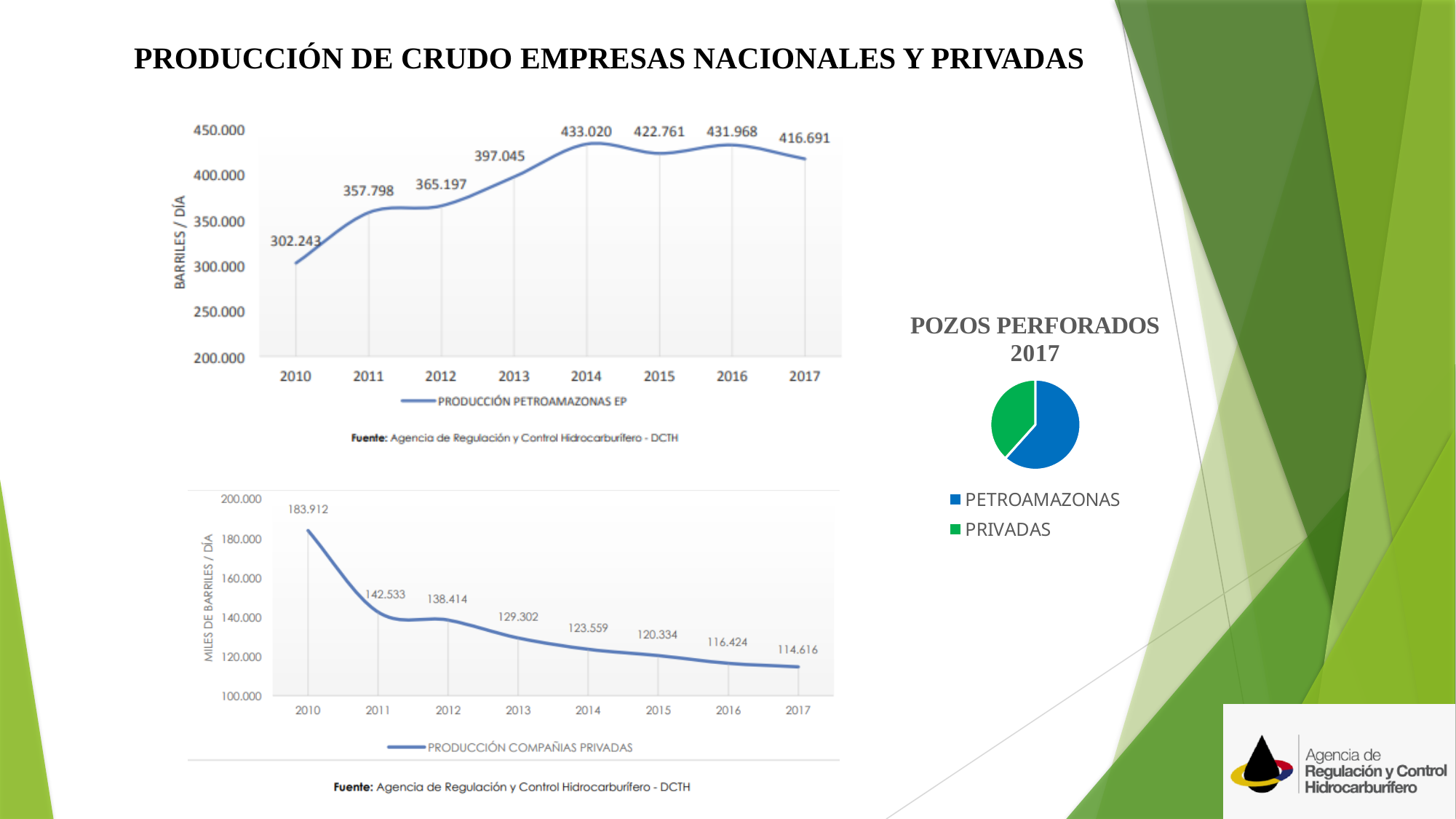
How many entries does the legend of the pie chart POZOS PERFORADOS 2017 list? 2 In the top chart (PRODUCCIÓN PETROAMAZONAS EP), which year has the lowest value? 2010 How many years are plotted in the bottom chart (PRODUCCIÓN COMPAÑIAS PRIVADAS)? 8 In the top chart (PRODUCCIÓN PETROAMAZONAS EP), what is the value for 2013? 397.045 In the pie chart POZOS PERFORADOS 2017, which slice is larger, PETROAMAZONAS or PRIVADAS? PETROAMAZONAS In the bottom chart (PRODUCCIÓN COMPAÑIAS PRIVADAS), do the values rise or fall from 2010 to 2017? Fall In the top chart (PRODUCCIÓN PETROAMAZONAS EP), which year has the highest value? 2014 In the top chart (PRODUCCIÓN PETROAMAZONAS EP), what is the difference between the 2014 value and the 2010 value? 130.777 In the bottom chart (PRODUCCIÓN COMPAÑIAS PRIVADAS), what is the value for 2011? 142.533 What kind of chart is the top chart, PRODUCCIÓN PETROAMAZONAS EP? Line chart In the top chart (PRODUCCIÓN PETROAMAZONAS EP), which is larger, the value for 2015 or the value for 2016? 2016 In the bottom chart (PRODUCCIÓN COMPAÑIAS PRIVADAS), what is the difference between the 2010 value and the 2017 value? 69.296